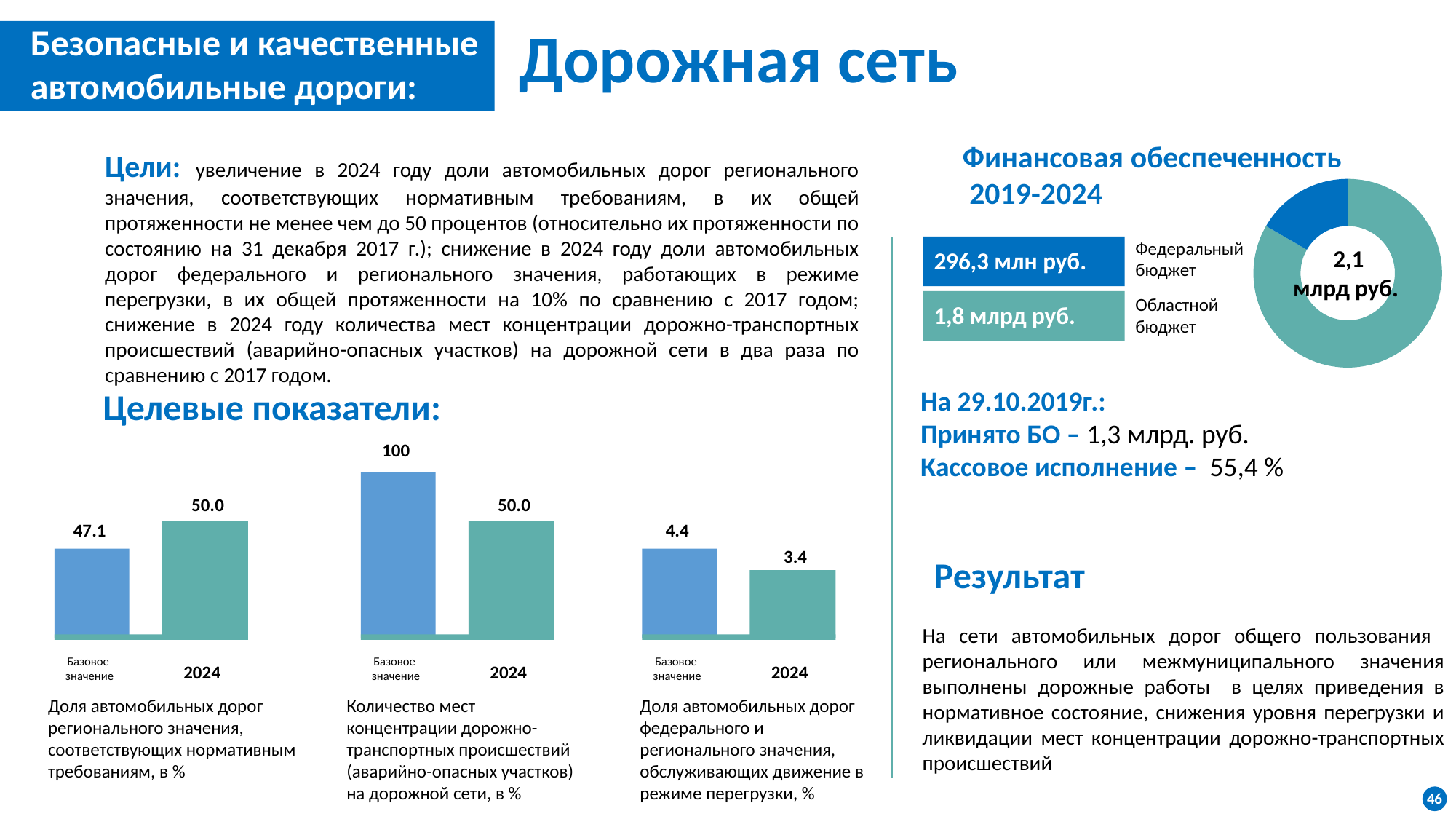
In the left bar chart (share of regional roads meeting standards), do the values rise or fall from 'Базовое значение' to 2024? rise In the middle bar chart (number of accident concentration sites), what is the value for 2024? 50.0 In the left bar chart (share of regional roads meeting standards), what is the value for 2024? 50.0 How many bars are in the right bar chart (share of roads operating in overload mode)? 2 In the 'Финансовая обеспеченность 2019-2024' chart, what total is shown in the centre of the donut? 2,1 млрд руб. In the right bar chart (share of roads operating in overload mode), what is the value for 2024? 3.4 In the middle bar chart (number of accident concentration sites), what is the value for 'Базовое значение'? 100 What kind of chart is the 'Финансовая обеспеченность 2019-2024' chart? donut (pie) chart In the middle bar chart (number of accident concentration sites), which category has the higher value, 'Базовое значение' or 2024? Базовое значение In the 'Финансовая обеспеченность 2019-2024' chart, what is the value for 'Федеральный бюджет'? 296,3 млн руб. In the right bar chart (share of roads operating in overload mode), what is the difference between 'Базовое значение' and 2024? 1.0 In the left bar chart (share of regional roads meeting standards), what is the value for 'Базовое значение'? 47.1